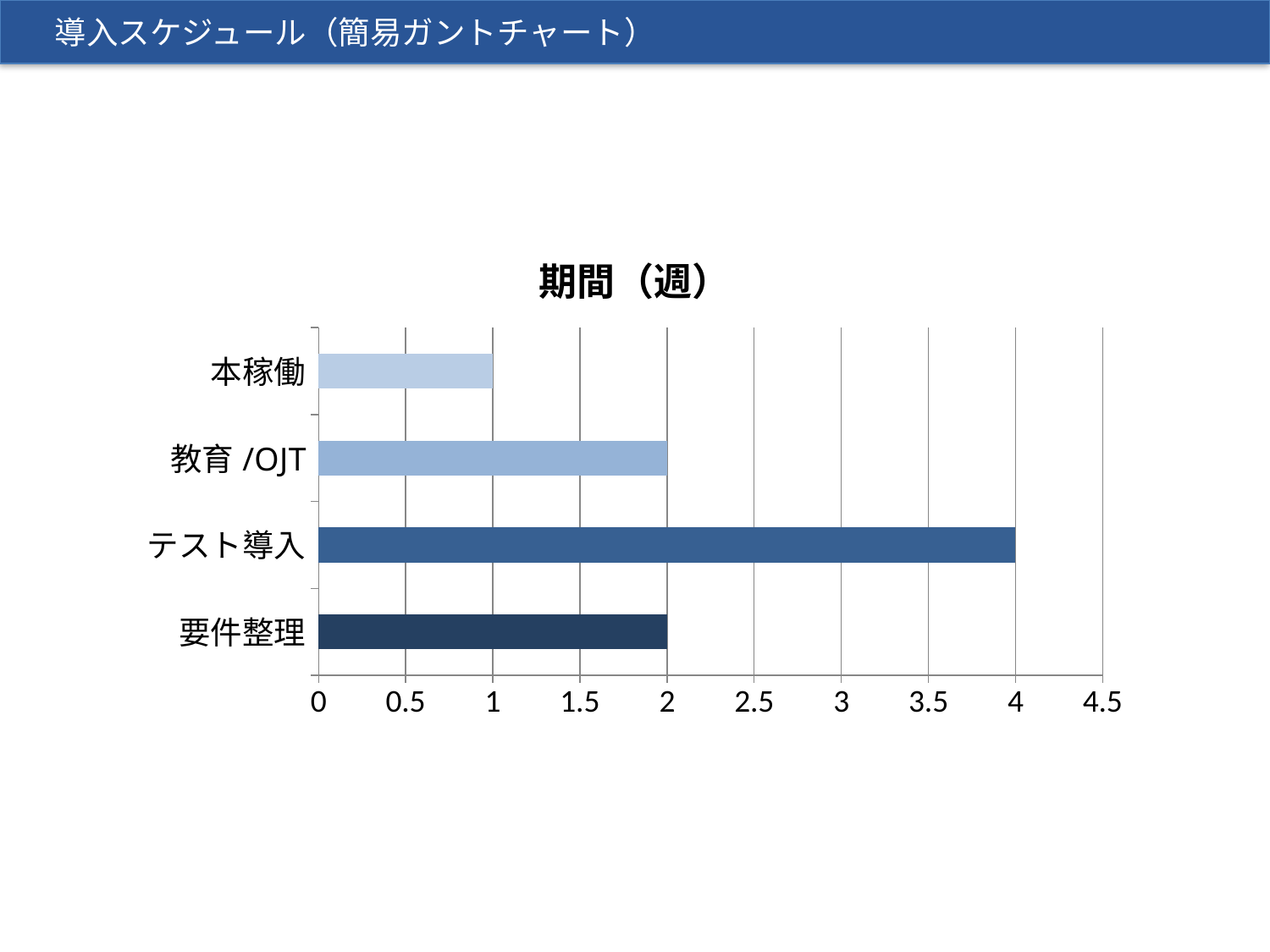
Which category has the lowest value? 本稼働 Which is larger, the value for テスト導入 or the value for 要件整理? テスト導入 What is the value for 要件整理? 2 What is the value for テスト導入? 4 Is the value for テスト導入 greater or less than 3? greater What is the difference between the values for テスト導入 and 本稼働? 3 How many categories are shown in the chart? 4 What is the value for 本稼働? 1 What is the title of the chart? 期間（週） What is the value for 教育 /OJT? 2 Which category has the highest value? テスト導入 What kind of chart is shown on the slide? bar chart